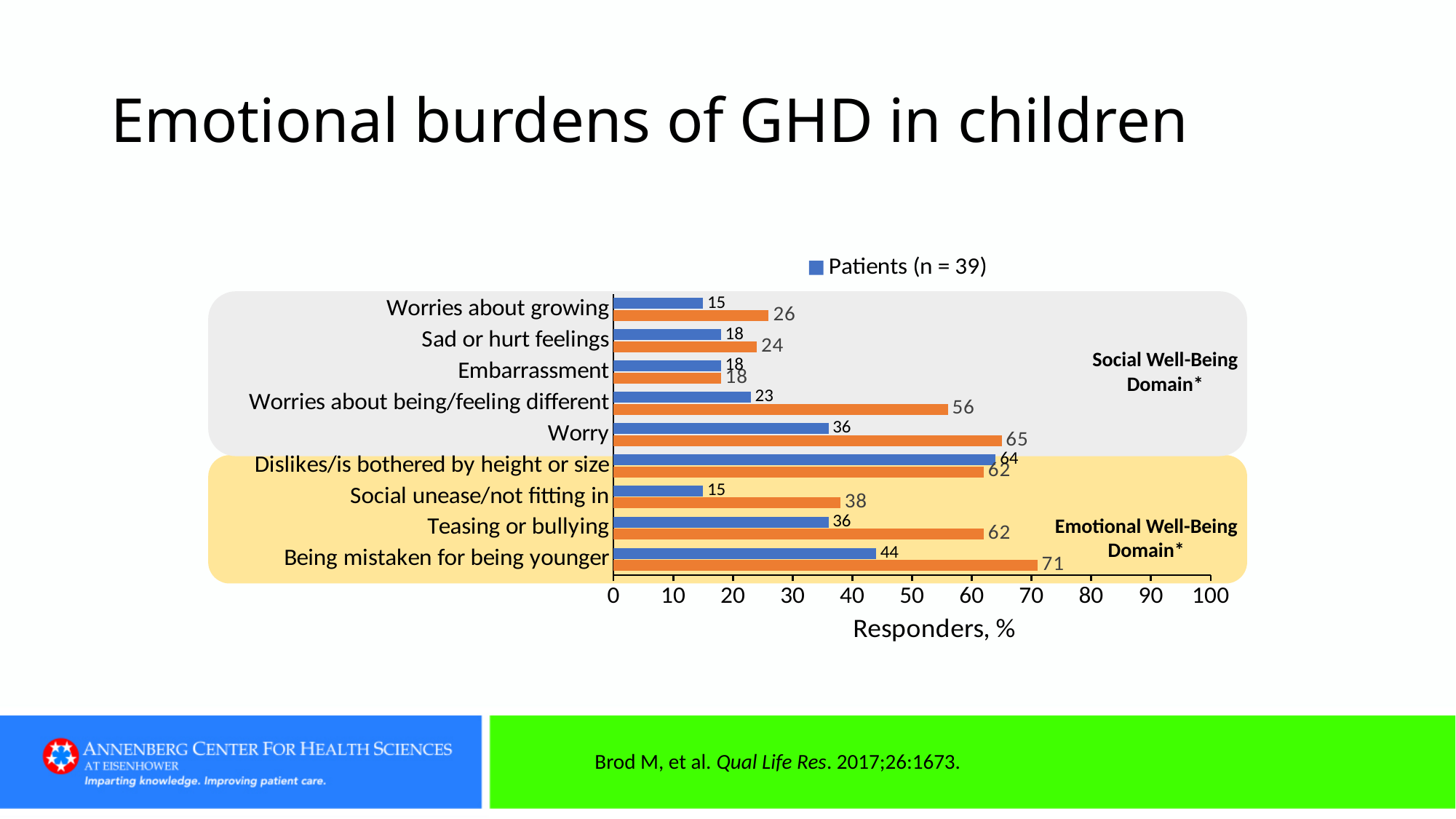
How many series does the legend list? 1 Which category has the highest Patients (n = 39) value? Dislikes/is bothered by height or size What kind of chart is shown on the slide? bar chart What is the Patients (n = 39) value for Worry? 36 How many categories are shown on the chart? 9 What is the label of the horizontal axis? Responders, % What is the difference between the Patients (n = 39) values for Being mistaken for being younger and Worries about growing? 29 Which has a larger Patients (n = 39) value: Teasing or bullying or Social unease/not fitting in? Teasing or bullying What is the Patients (n = 39) value for Dislikes/is bothered by height or size? 64 What is the Patients (n = 39) value for Worries about being/feeling different? 23 What is the Patients (n = 39) value for Being mistaken for being younger? 44 Is the Patients (n = 39) value for Dislikes/is bothered by height or size greater or less than 50? greater